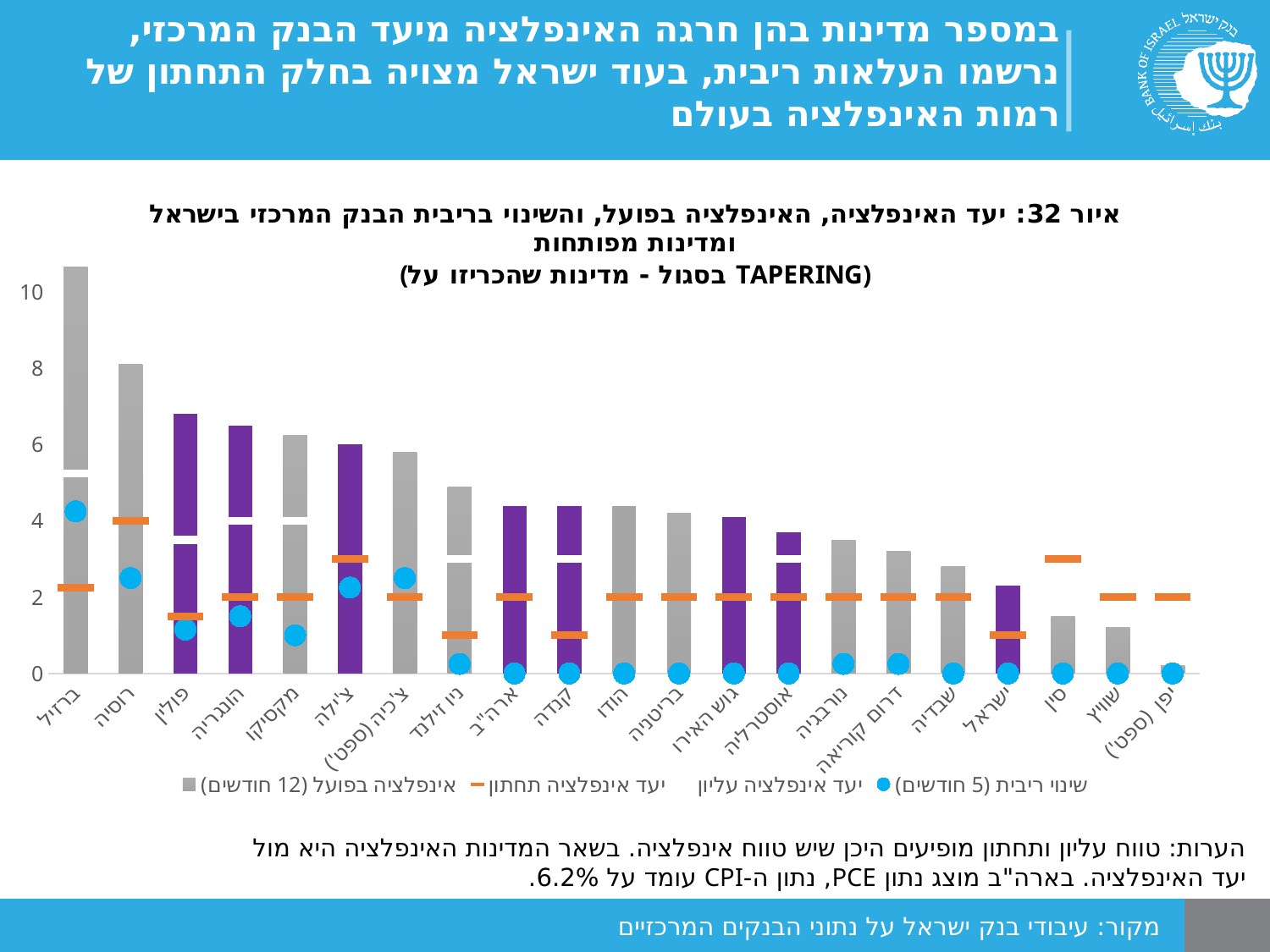
Is the actual inflation bar for שוויץ greater or less than 2? less Is the actual inflation bar for ישראל greater or less than 2? greater Which country has the highest actual inflation (אינפלציה בפועל) bar? ברזיל Which country has the lowest actual inflation (אינפלציה בפועל) bar? יפן (ספט') How many series does the chart legend list? 4 According to the chart title, what do the purple bars indicate? מדינות שהכריזו על TAPERING What kind of chart is shown on the slide? bar chart Which has the higher actual inflation bar, פולין or צ'כיה (ספט')? פולין How many countries are shown on the x axis of the chart? 21 Do the actual inflation bars generally rise or fall moving from left to right along the x axis? fall Is the actual inflation bar for ברזיל greater or less than 10? greater